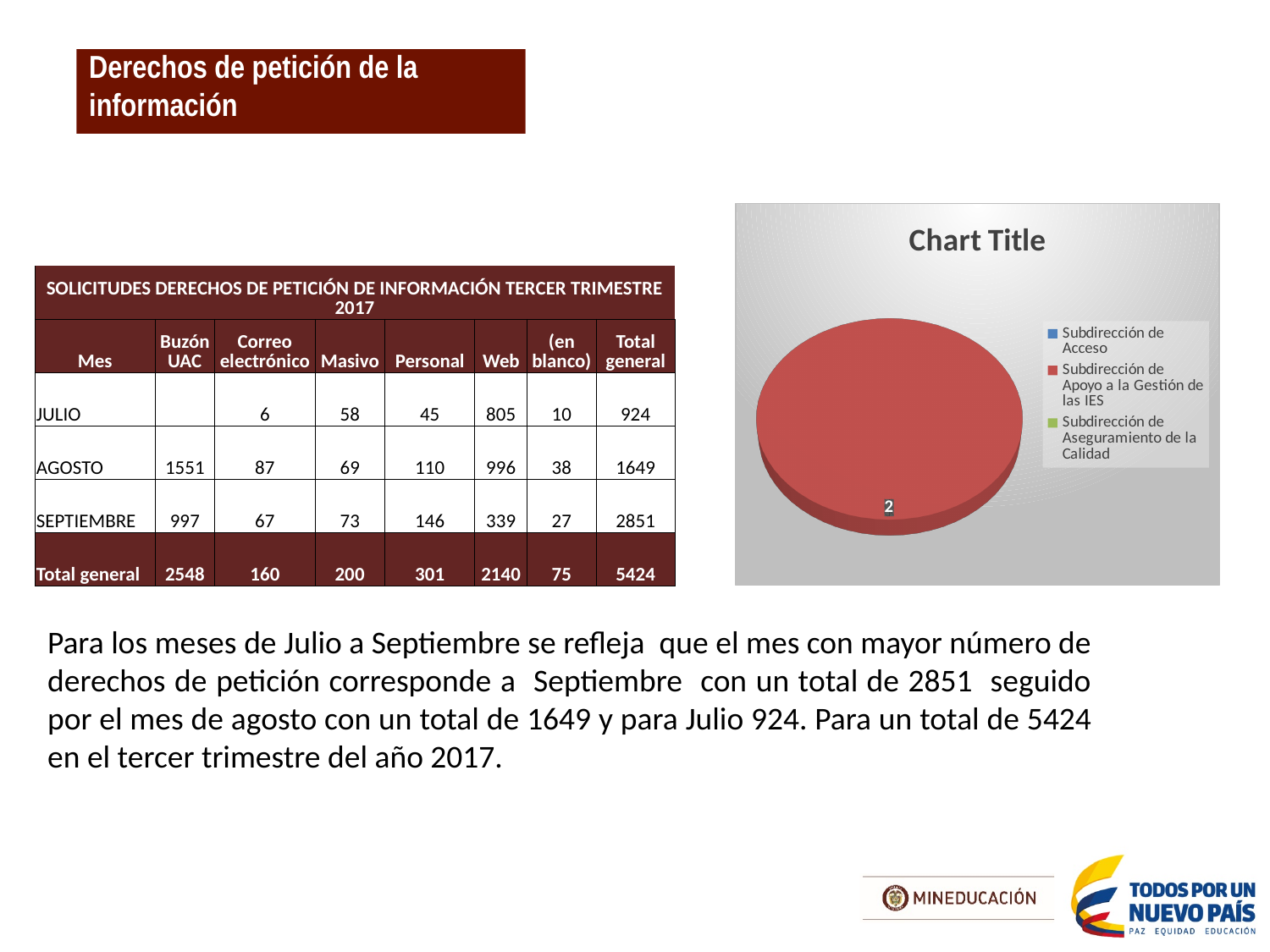
What is the title shown above the pie chart? Chart Title What is the first entry listed in the pie chart's legend? Subdirección de Acceso What value is printed as the data label on the pie chart's red slice? 2 According to the legend, which category does the red slice of the pie chart represent? Subdirección de Apoyo a la Gestión de las IES How many entries does the legend of the pie chart list? 3 What kind of chart is shown on the right of the slide? pie chart How many slices are visibly drawn in the pie chart? 1